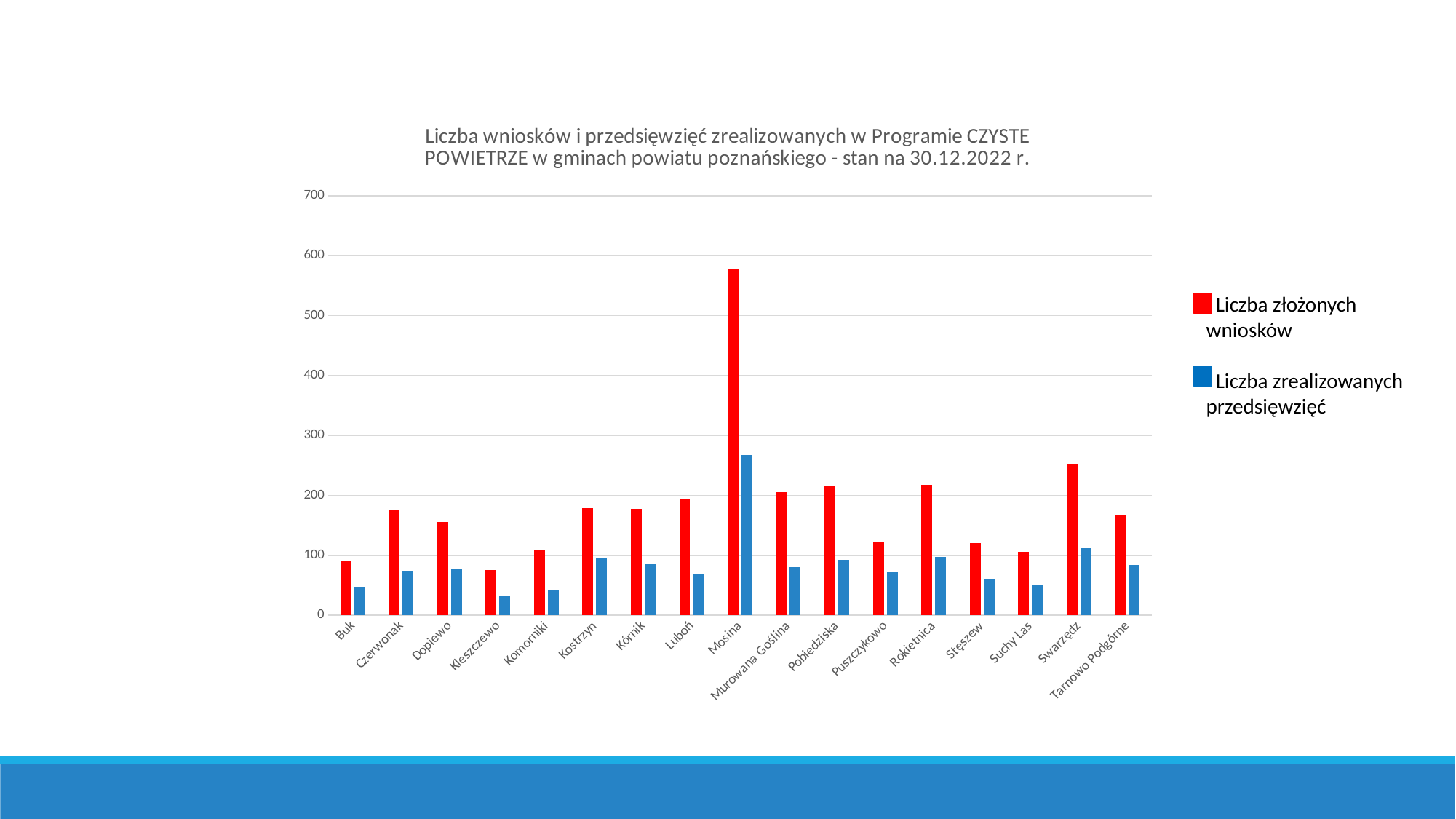
Is the value of Liczba zrealizowanych przedsięwzięć for Mosina greater or less than 300? less What kind of chart is shown on the slide? bar chart Which has the larger value for Liczba złożonych wniosków, Swarzędz or Rokietnica? Swarzędz Which colour represents Liczba zrealizowanych przedsięwzięć in the legend? blue Is the value of Liczba złożonych wniosków for Swarzędz greater or less than 200? greater Which gmina has the highest value for Liczba złożonych wniosków? Mosina Is the value of Liczba złożonych wniosków for Mosina greater or less than 500? greater Which gmina has the lowest value for Liczba złożonych wniosków? Kleszczewo How many gminas (categories) are shown on the x axis? 17 Which gmina has the lowest value for Liczba zrealizowanych przedsięwzięć? Kleszczewo How many series does the legend list? 2